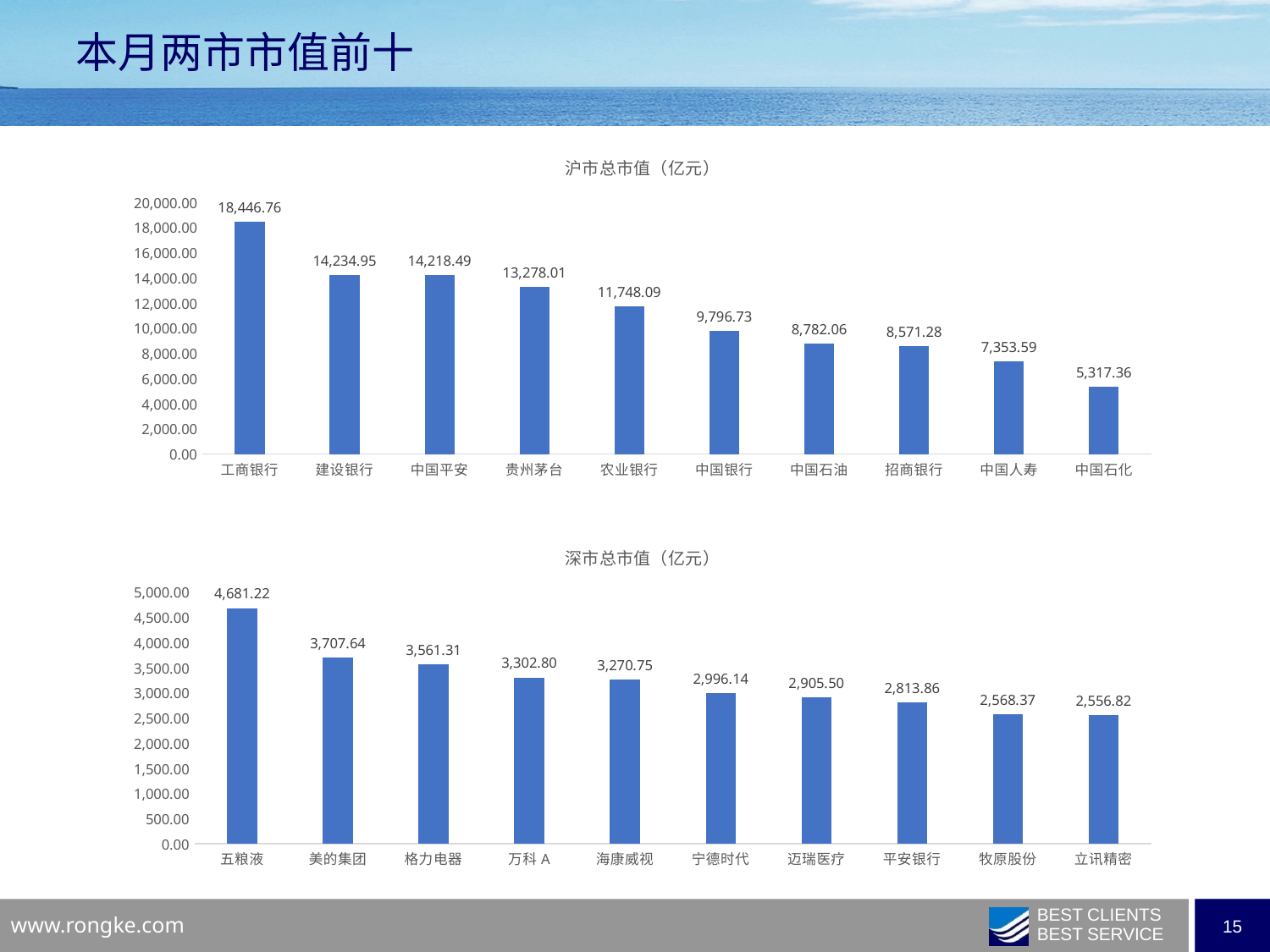
In the 沪市总市值（亿元） chart, how many categories are shown? 10 In the 沪市总市值（亿元） chart, what is the value for 工商银行? 18,446.76 What type of chart is the 深市总市值（亿元） chart? bar chart In the 深市总市值（亿元） chart, what is the difference between 五粮液 and 美的集团? 973.58 In the 沪市总市值（亿元） chart, what is the value for 贵州茅台? 13,278.01 In the 深市总市值（亿元） chart, which category has the highest value? 五粮液 In the 深市总市值（亿元） chart, what is the value for 宁德时代? 2,996.14 In the 沪市总市值（亿元） chart, which category has the lowest value? 中国石化 What is the title of the top chart on the slide? 沪市总市值（亿元） In the 沪市总市值（亿元） chart, what is the difference between 工商银行 and 建设银行? 4,211.81 In the 深市总市值（亿元） chart, which is larger, 格力电器 or 万科 A? 格力电器 In the 沪市总市值（亿元） chart, do the values rise or fall from left to right? fall